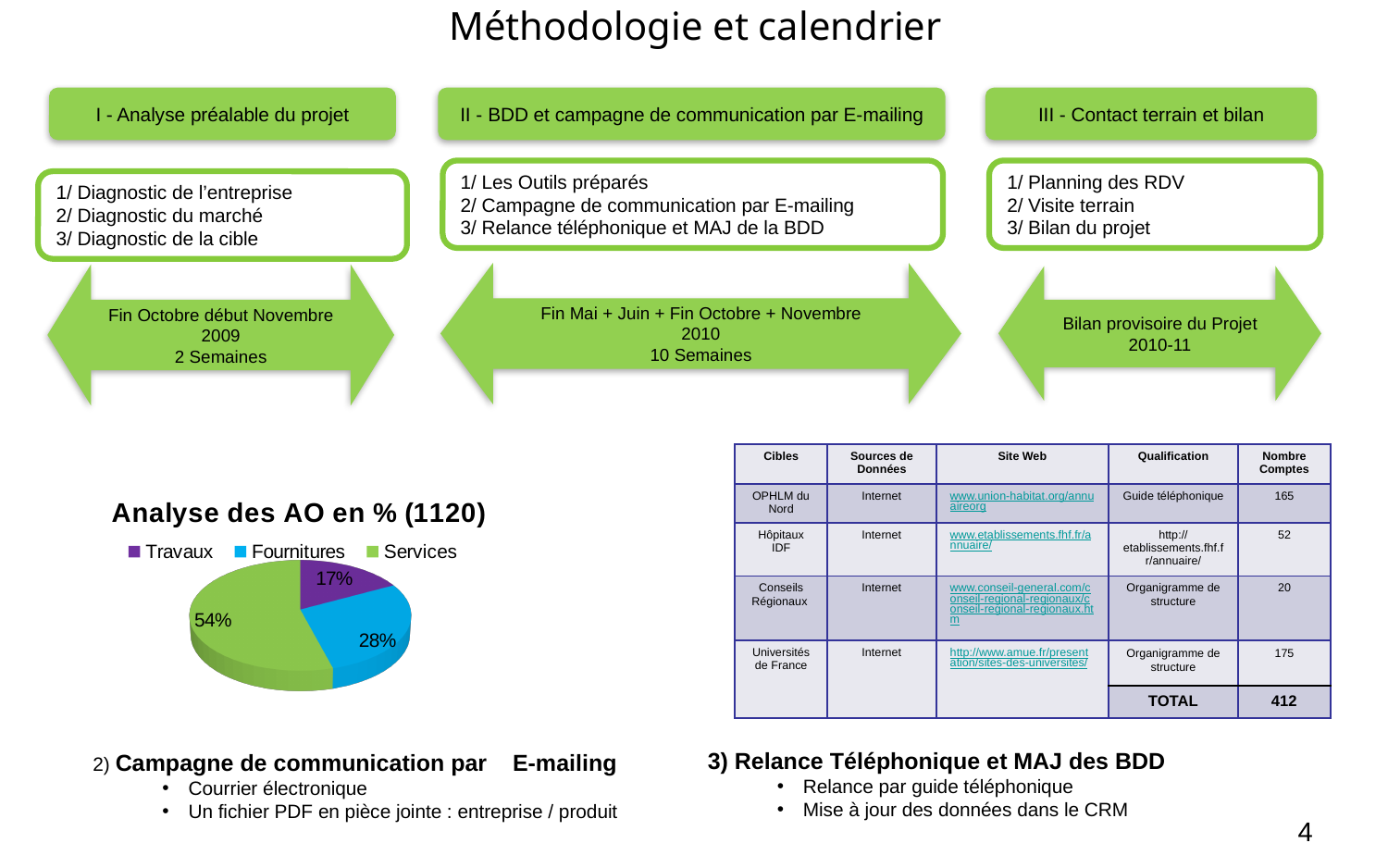
In the pie chart, what percentage is shown for Fournitures? 28% In the pie chart, which is larger: Fournitures or Travaux? Fournitures In the pie chart, what is the difference in percentage points between Fournitures and Travaux? 11 In the pie chart, what percentage is shown for Services? 54% In the pie chart, what percentage is shown for Travaux? 17% In the pie chart, what is the difference in percentage points between Services and Fournitures? 26 Which colour represents Services in the pie chart? green Which category has the smallest slice in the pie chart? Travaux How many categories does the pie chart legend list? 3 What type of chart is shown under the title "Analyse des AO en % (1120)"? pie chart Which category has the largest slice in the pie chart? Services What is the title of the pie chart on the slide? Analyse des AO en % (1120)